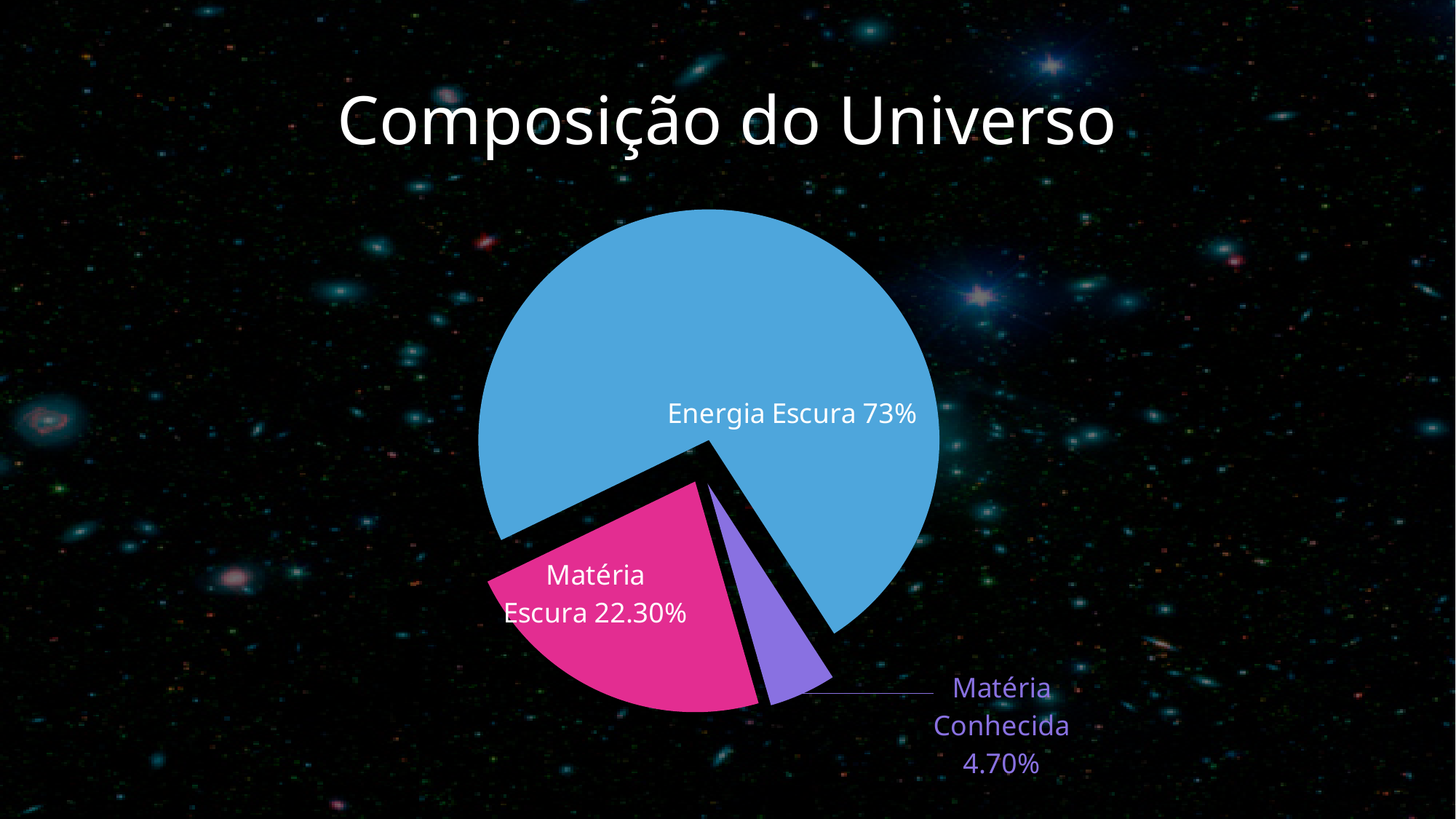
What colour is the Energia Escura slice? blue What is the difference in percentage points between Energia Escura and Matéria Escura? 50.70 Which slice of the pie is the smallest? Matéria Conhecida What is the title of the chart? Composição do Universo Which slice of the pie is the largest? Energia Escura What is the difference in percentage points between Matéria Escura and Matéria Conhecida? 17.60 How many slices does the pie chart have? 3 What percentage is shown for Energia Escura? 73% What percentage is shown for Matéria Conhecida? 4.70% Which is larger, Matéria Escura or Matéria Conhecida? Matéria Escura What kind of chart is shown on the slide? pie chart What percentage is shown for Matéria Escura? 22.30%